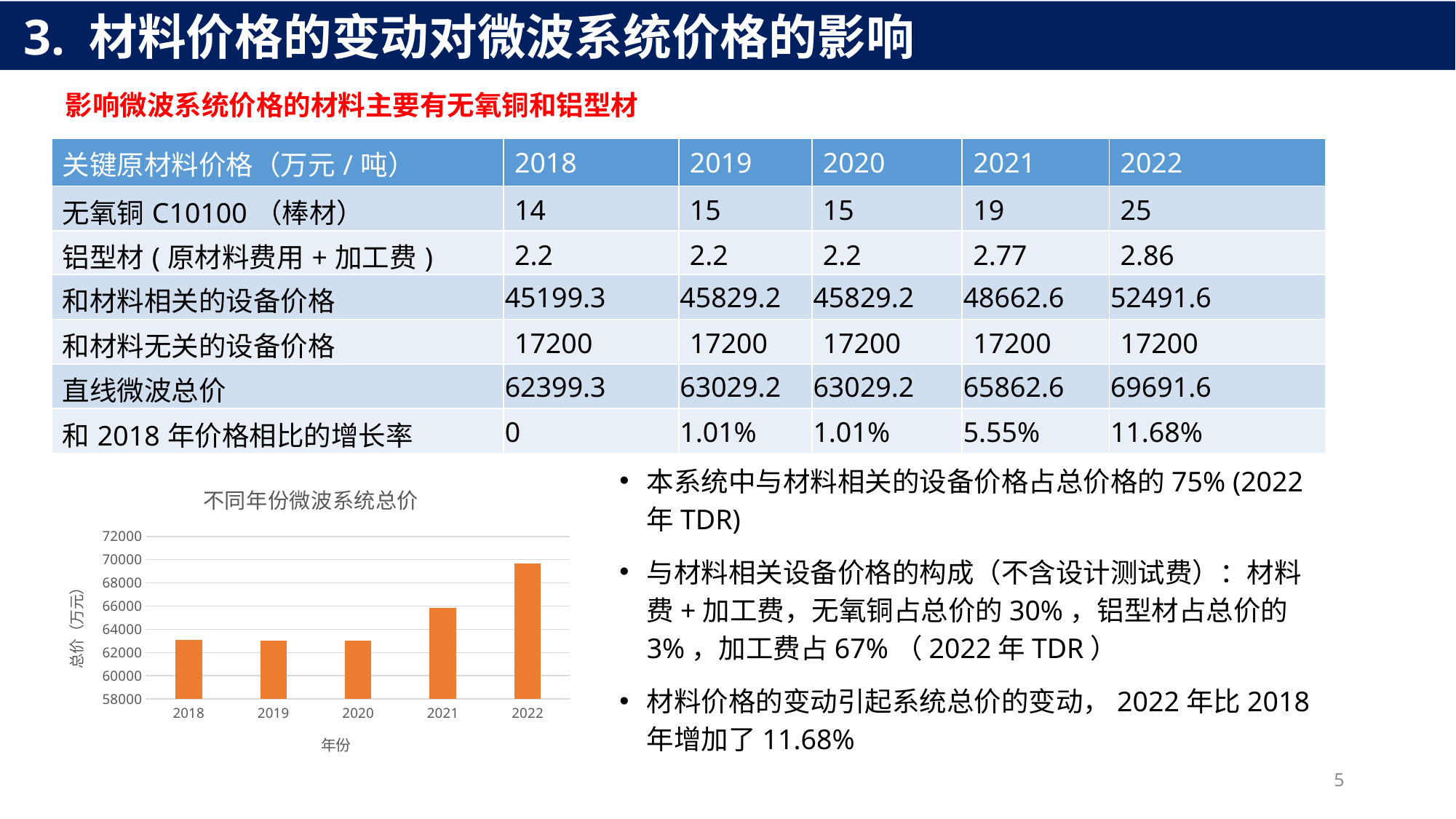
In the chart, which bar is taller, 2018 or 2021? 2021 What kind of chart is shown on the slide? bar chart In the chart, is the bar for 2021 greater or less than 64000? greater In the chart, is the bar for 2022 greater or less than 68000? greater In the chart, which bar is taller, 2021 or 2022? 2022 In the chart, is the bar for 2020 greater or less than 62000? greater How many years (bars) are plotted in the chart? 5 What is the label of the x axis of the chart? 年份 What is the title of the chart on the slide? 不同年份微波系统总价 Which year has the highest bar in the chart? 2022 Do the bar values in the chart generally rise or fall from 2018 to 2022? rise